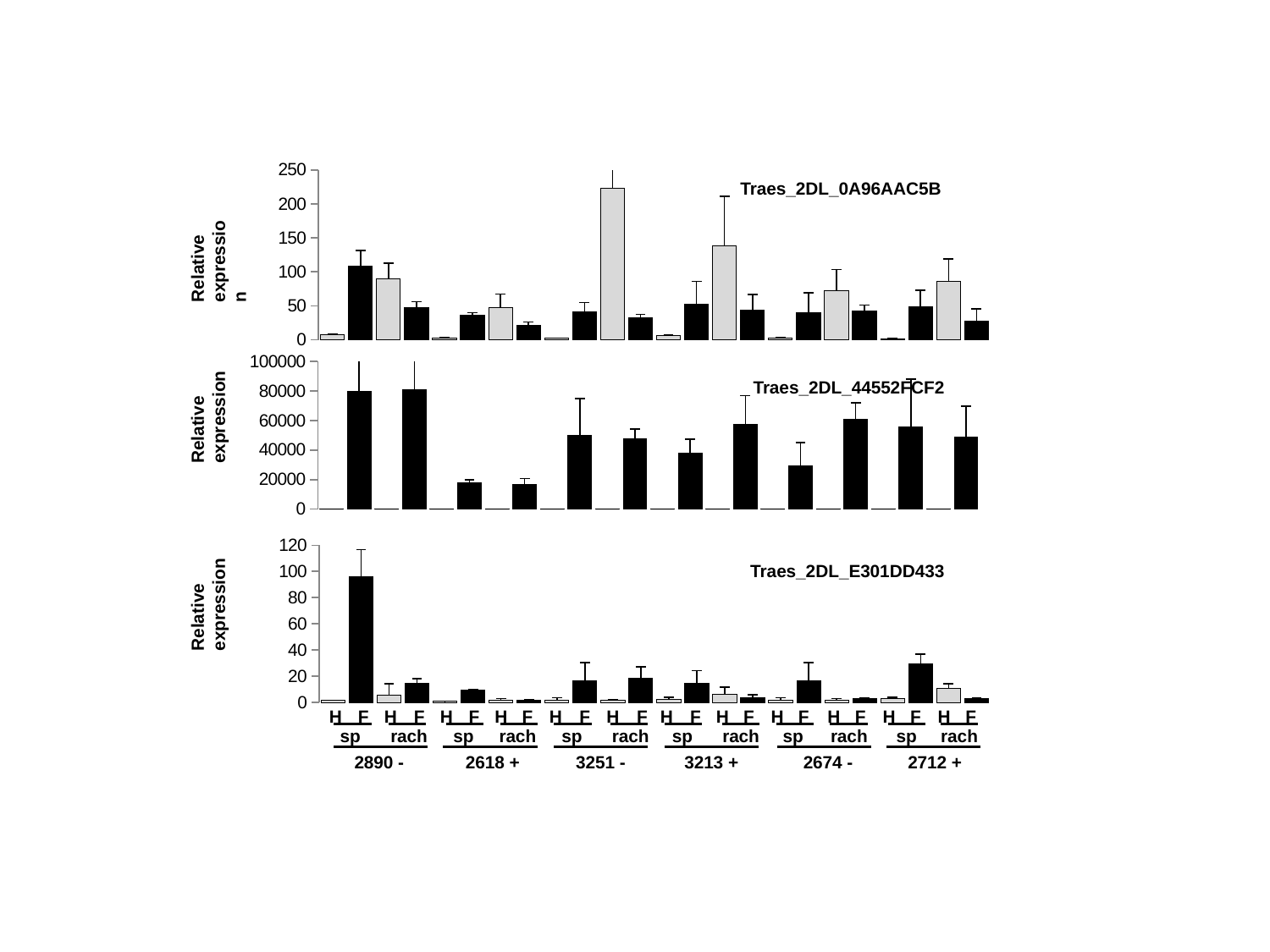
In the bottom chart (Traes_2DL_E301DD433), which bar is the tallest? 2890 - sp F What kind of chart is the top chart titled Traes_2DL_0A96AAC5B? bar chart In the top chart (Traes_2DL_0A96AAC5B), which bar is the tallest? 3251 - rach H What is the highest tick value shown on the y axis of the top chart (Traes_2DL_0A96AAC5B)? 250 In the top chart (Traes_2DL_0A96AAC5B), is the value for 3251 - rach F greater or less than 200? less In the middle chart (Traes_2DL_44552FCF2), which is larger, the value for 2618 + sp F or the value for 3251 - sp F? 3251 - sp F In the bottom chart (Traes_2DL_E301DD433), is the value for 2890 - sp F greater or less than 80? greater In the bottom chart (Traes_2DL_E301DD433), which is larger, the value for 2890 - sp F or the value for 2712 + sp F? 2890 - sp F In the middle chart (Traes_2DL_44552FCF2), is the value for 2890 - sp F greater or less than 60000? greater How many line groups (e.g. 2890 -, 2618 +) are labelled along the x axis of the bottom chart? 6